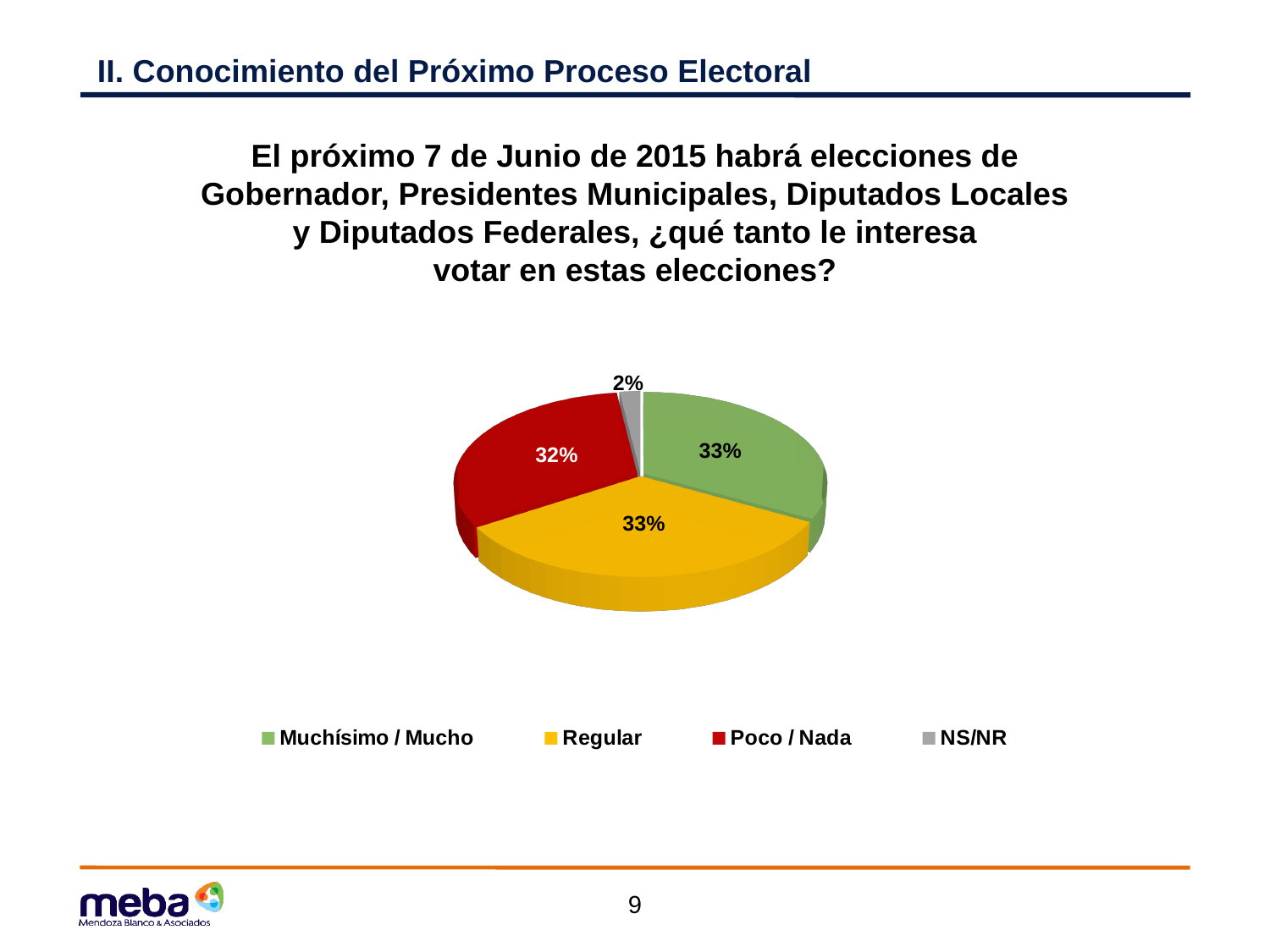
What kind of chart is shown on the slide? pie chart What percentage of respondents answered "NS/NR"? 2% Which category is shown in red in the legend? Poco / Nada Which is larger, the share for "Poco / Nada" or the share for "NS/NR"? Poco / Nada What is the difference in percentage points between "Regular" and "Poco / Nada"? 1 percentage point What percentage of respondents answered "Regular"? 33% What percentage of respondents answered "Muchísimo / Mucho"? 33% What percentage of respondents answered "Poco / Nada"? 32% How many categories does the pie chart show? 4 What colour is the slice for "Regular"? yellow What is the difference in percentage points between "Poco / Nada" and "NS/NR"? 30 percentage points Which category has the smallest slice of the pie? NS/NR